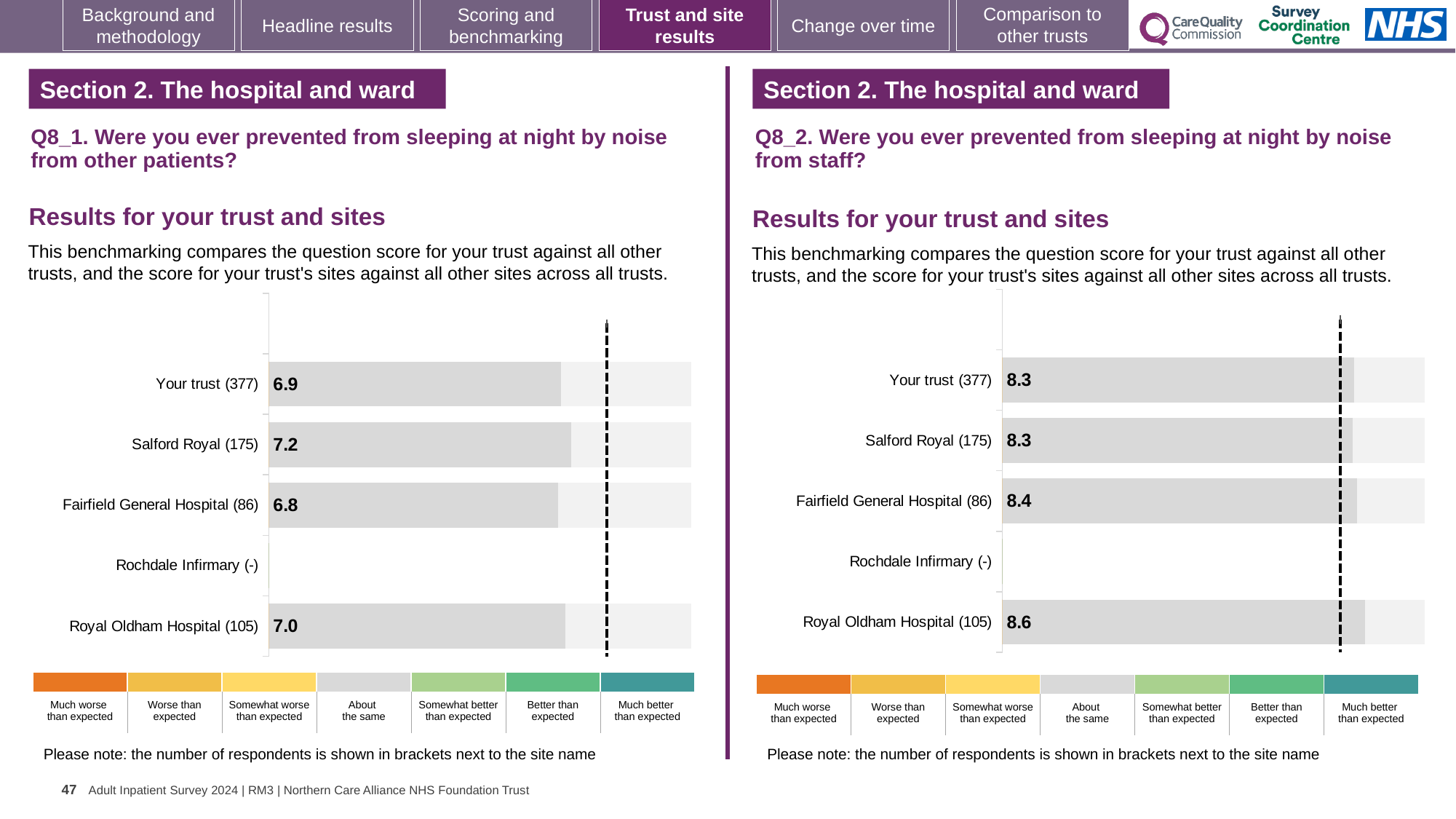
On the Q8_2 chart (right), which site has the highest score? Royal Oldham Hospital On the Q8_1 chart (left), what is the score for Royal Oldham Hospital? 7.0 On the Q8_1 chart (left), which site has the highest score? Salford Royal On the Q8_1 chart (left), which has the higher score, Your trust or Royal Oldham Hospital? Royal Oldham Hospital On the Q8_1 chart (left), which site has the lowest score? Fairfield General Hospital On the Q8_2 chart (right), what is the difference between the scores for Royal Oldham Hospital and Your trust? 0.3 What kind of chart is used on the Q8_1 chart (left)? Bar chart On the Q8_1 chart (left), what is the score for Your trust? 6.9 On the Q8_2 chart (right), what is the score for Fairfield General Hospital? 8.4 On the Q8_2 chart (right), what is the score for Royal Oldham Hospital? 8.6 On the Q8_1 chart (left), what is the difference between the scores for Salford Royal and Fairfield General Hospital? 0.4 How many sites or rows are listed on the Q8_2 chart (right)? 5